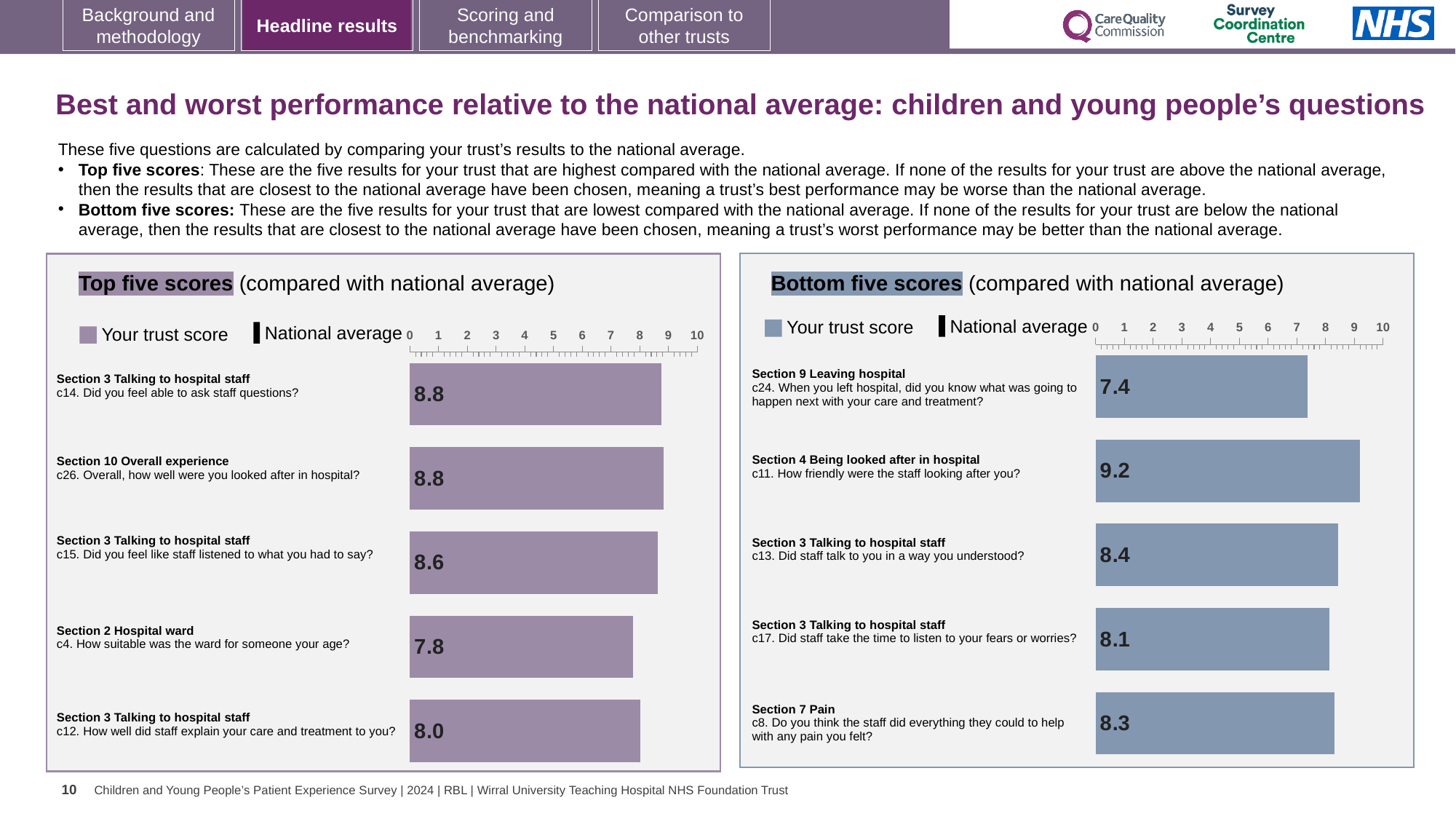
In the Bottom five scores chart, which question has the highest trust score? c11. How friendly were the staff looking after you? How many entries does the legend of the Top five scores chart list? 2 How many questions are plotted in the Top five scores chart? 5 What type of chart is the Bottom five scores chart? bar chart In the Top five scores chart, what is the difference between the trust score for c14 and the trust score for c4? 1.0 In the Bottom five scores chart, is the trust score for c24 greater or less than 8? less In the Top five scores chart, what is the trust score for c12 'How well did staff explain your care and treatment to you?' 8.0 In the Bottom five scores chart, which has the larger trust score: c13 'Did staff talk to you in a way you understood?' or c17 'Did staff take the time to listen to your fears or worries?' c13. Did staff talk to you in a way you understood? In the Top five scores chart, which question has the lowest trust score? c4. How suitable was the ward for someone your age? In the Top five scores chart, what is the trust score for c15 'Did you feel like staff listened to what you had to say?' 8.6 In the Bottom five scores chart, which question has the lowest trust score? c24. When you left hospital, did you know what was going to happen next with your care and treatment? In the Bottom five scores chart, what is the trust score for c24 'When you left hospital, did you know what was going to happen next with your care and treatment?' 7.4